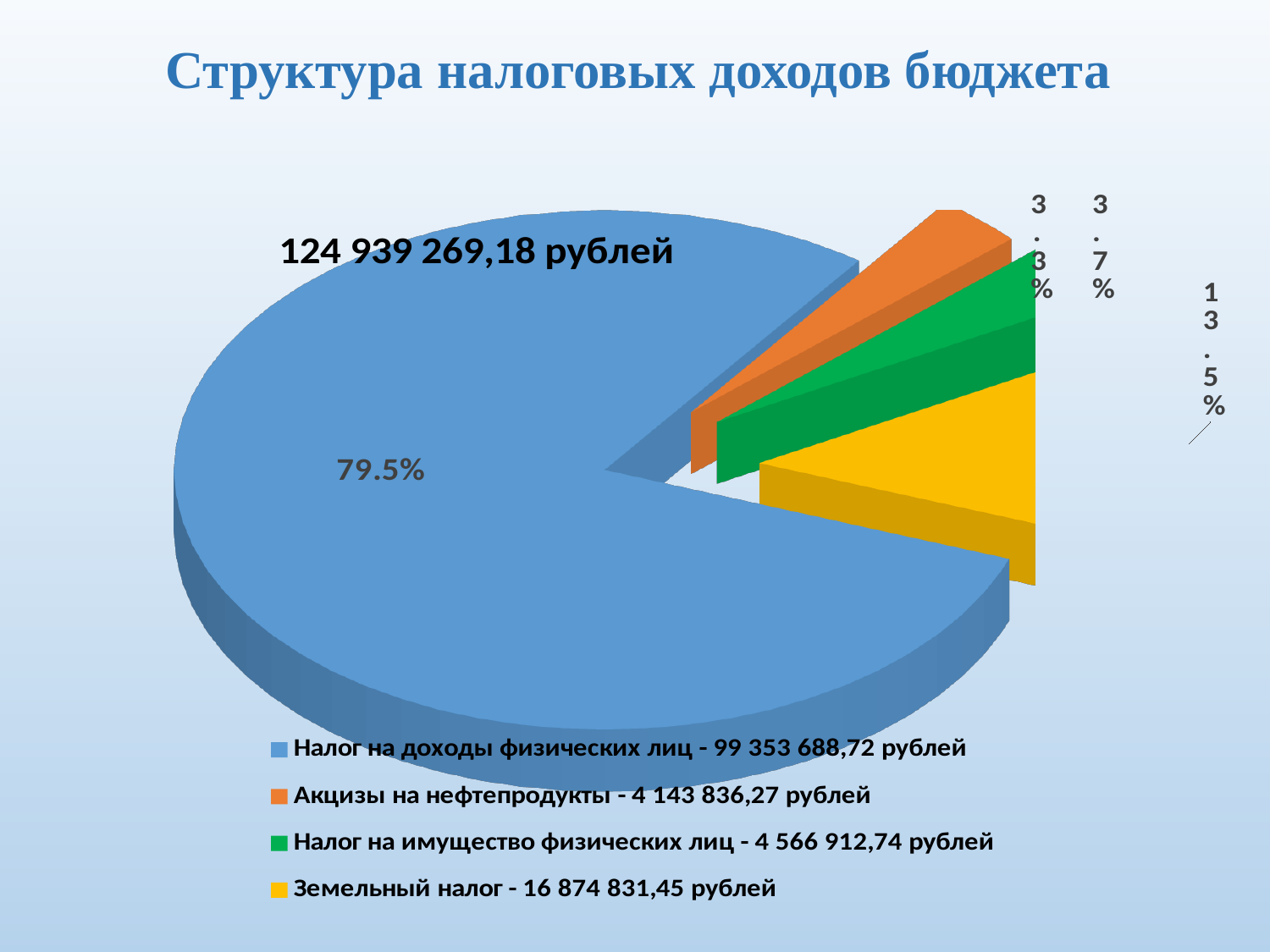
What is the title of the chart? 124 939 269,18 рублей Which is larger: Налог на имущество физических лиц or Земельный налог? Земельный налог What is the total amount shown for all tax revenues? 124 939 269,18 рублей What share of the pie does Налог на доходы физических лиц take? 79.5% Which category has the largest slice? Налог на доходы физических лиц Which category has the smallest slice? Акцизы на нефтепродукты What kind of chart is shown on the slide? pie chart How many slices does the pie chart have? 4 What is the value for Налог на доходы физических лиц? 99 353 688,72 рублей What is the value for Земельный налог? 16 874 831,45 рублей What share of the pie does Земельный налог take? 13.5% What is the value for Акцизы на нефтепродукты? 4 143 836,27 рублей